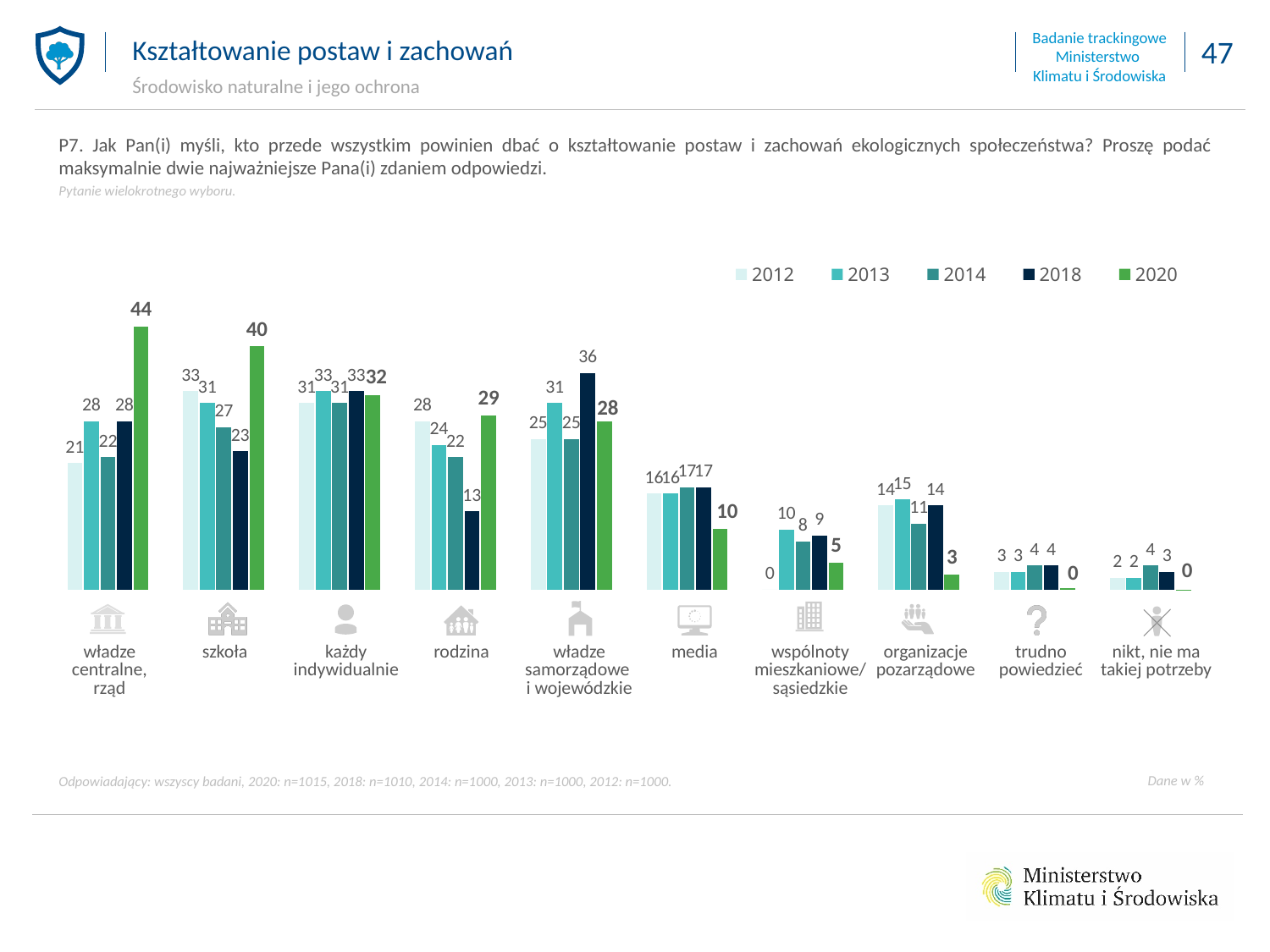
What is the difference between the 2020 and 2018 values for 'organizacje pozarządowe'? 11 What kind of chart is shown on the slide? bar chart How many categories are shown on the x axis? 10 Which is larger for 'media': the 2014 value or the 2020 value? 2014 Which category has the highest value in the 2020 series? władze centralne, rząd Which category has the lowest value in the 2012 series? wspólnoty mieszkaniowe/sąsiedzkie What is the difference between the 2020 and 2018 values for 'władze centralne, rząd'? 16 What is the value for 'szkoła' in 2018? 23 What is the value for 'władze samorządowe i wojewódzkie' in 2018? 36 What is the value for 'rodzina' in 2018? 13 What is the value for 'władze centralne, rząd' in 2020? 44 How many series does the legend list? 5